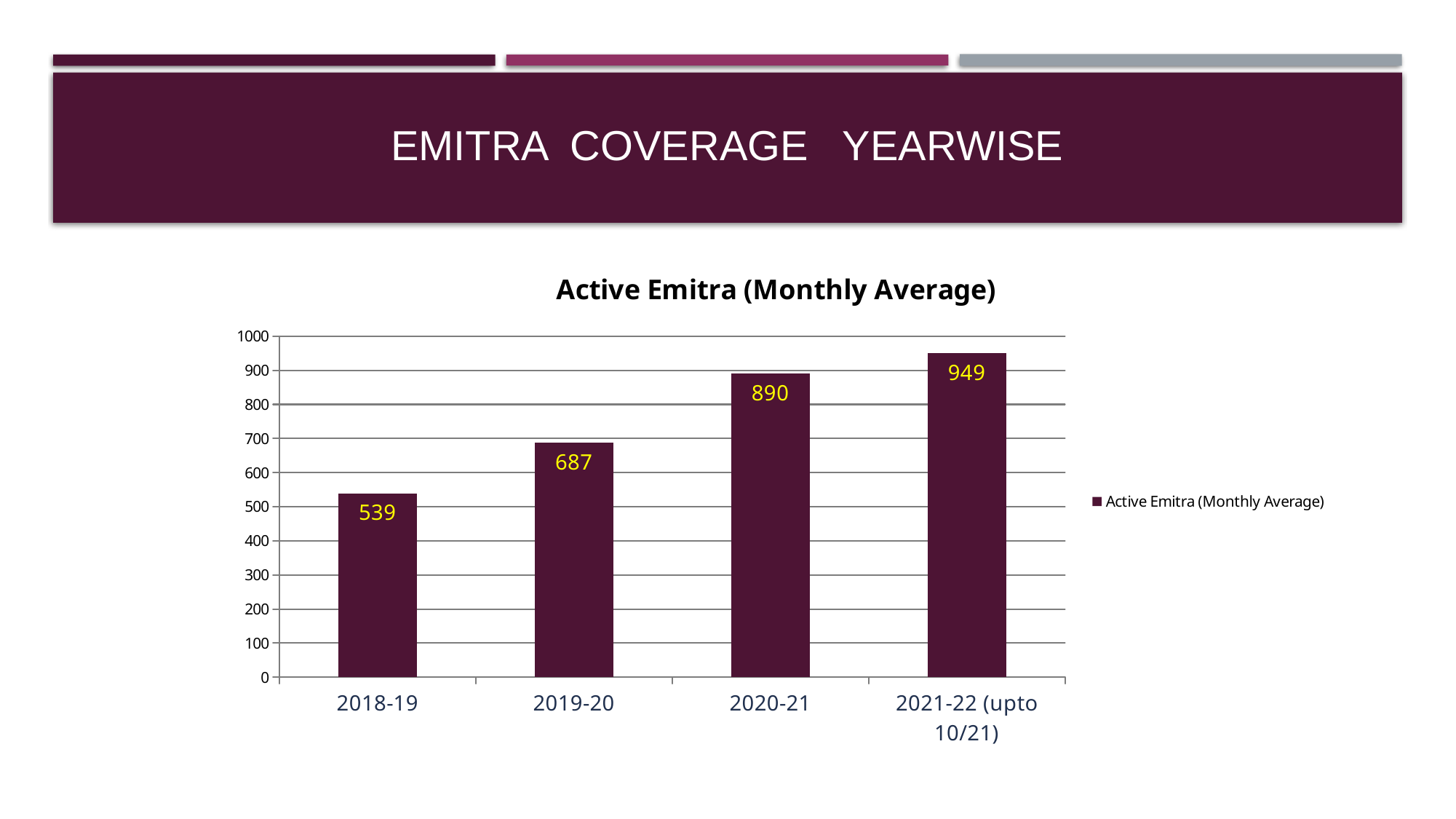
What is the Active Emitra (Monthly Average) value for 2018-19? 539 What is the difference between the Active Emitra values for 2020-21 and 2019-20? 203 How many years are shown on the x axis of the chart? 4 What is the Active Emitra (Monthly Average) value for 2019-20? 687 Is the Active Emitra value for 2020-21 greater or less than 800? greater Do the Active Emitra values rise or fall from 2018-19 to 2021-22 (upto 10/21)? Rise Which year has the lowest Active Emitra (Monthly Average)? 2018-19 What is the Active Emitra (Monthly Average) value for 2020-21? 890 Which year has the highest Active Emitra (Monthly Average)? 2021-22 (upto 10/21) What is the Active Emitra (Monthly Average) value for 2021-22 (upto 10/21)? 949 Which is larger, the Active Emitra value for 2019-20 or for 2018-19? 2019-20 What kind of chart is shown on the slide? Bar chart